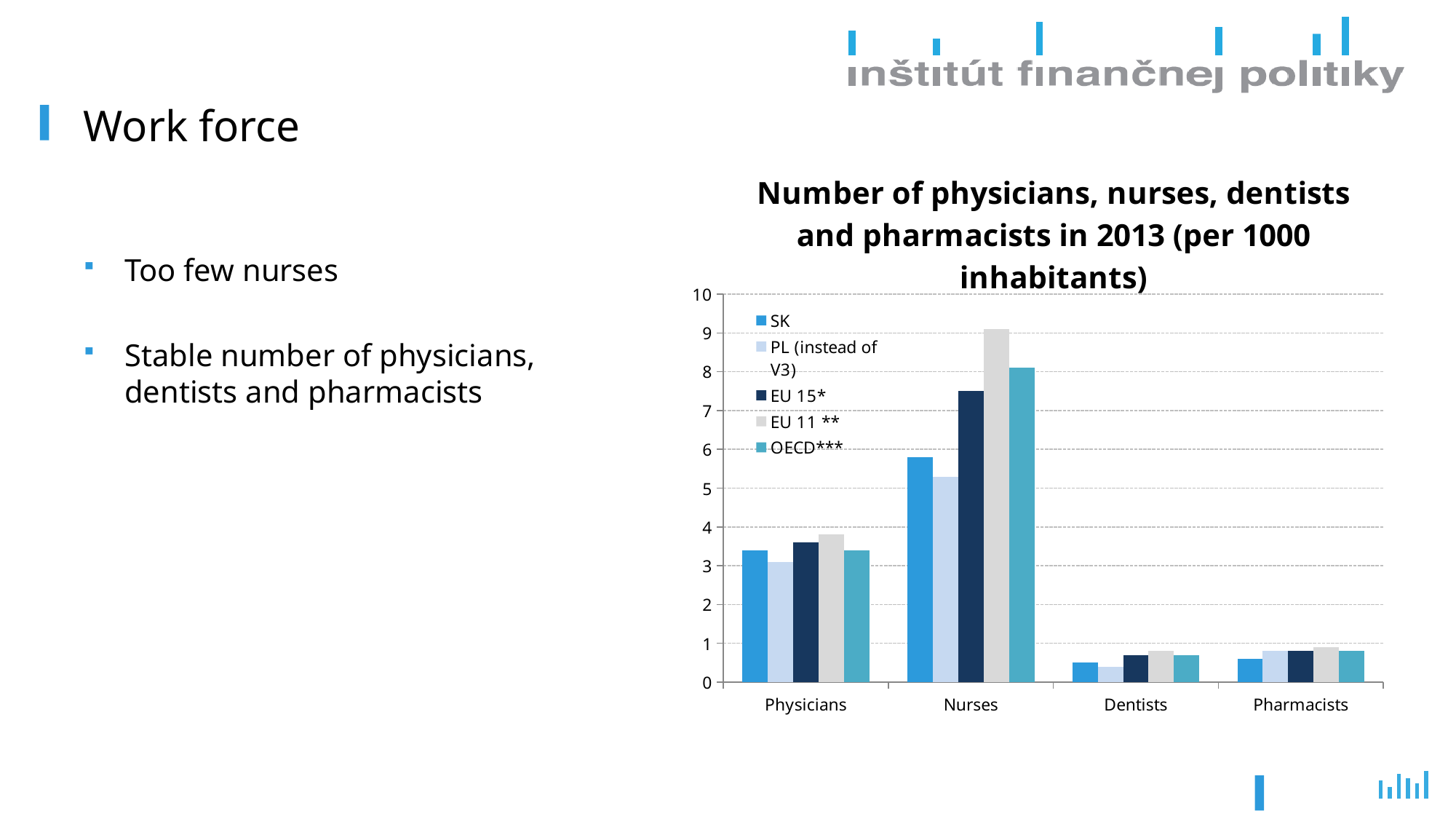
For Nurses, which series has the lowest value? PL (instead of V3) How many series does the chart's legend list? 5 How many categories are shown on the x axis of the chart? 4 Is the SK value for Nurses greater or less than 5? greater Is the EU 11 ** value for Nurses greater or less than 8? greater Is the SK value for Physicians greater or less than 4? less For Nurses, which series has the highest value? EU 11 ** What is the title of the chart? Number of physicians, nurses, dentists and pharmacists in 2013 (per 1000 inhabitants) What is the second entry in the chart's legend? PL (instead of V3) Which category has the highest values across all series? Nurses For Nurses, which is larger: the SK value or the EU 15* value? EU 15* What kind of chart is shown on the slide? bar chart